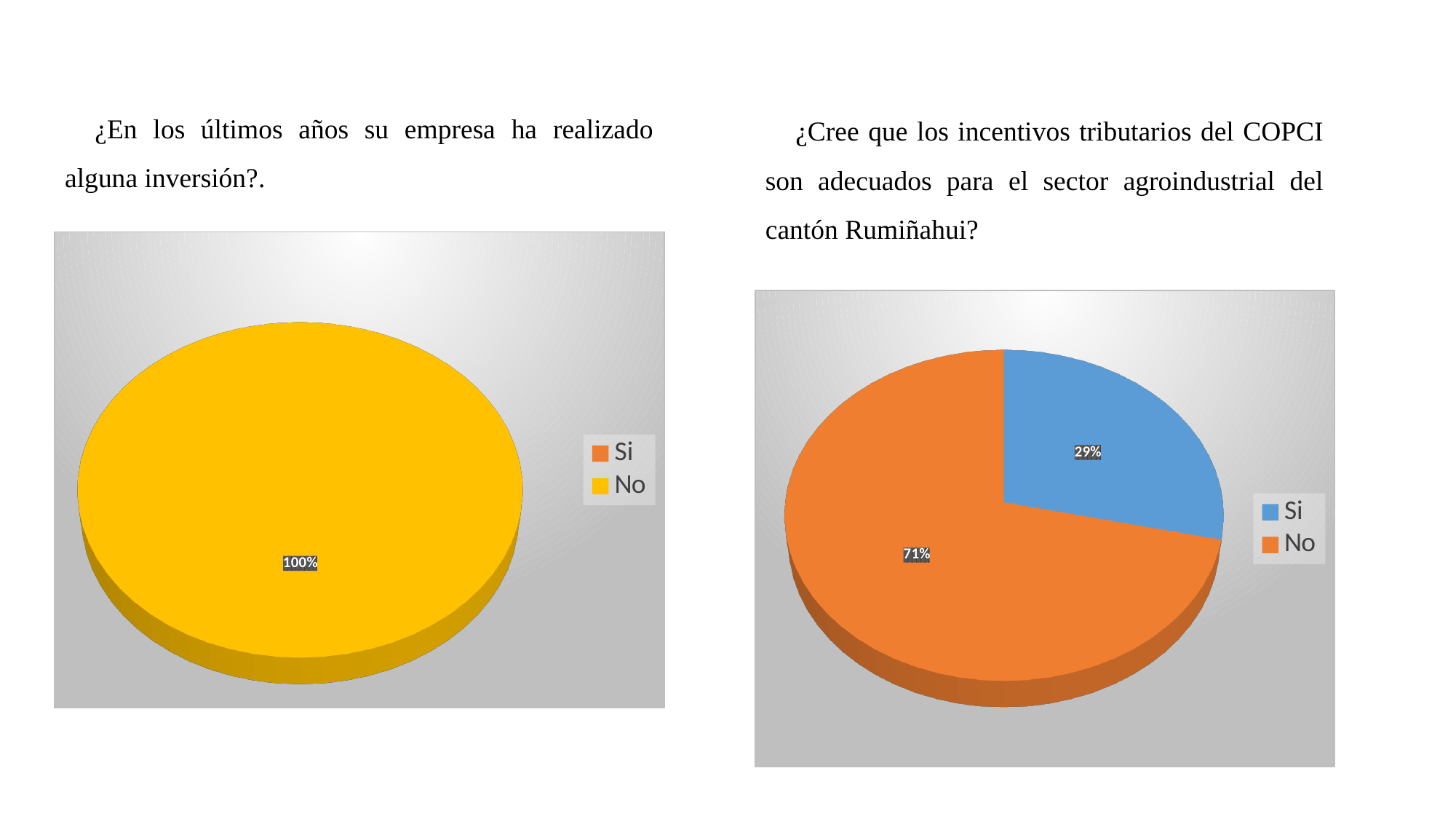
In the right pie chart, what is the difference in percentage points between the 'No' and 'Si' slices? 42 In the right pie chart, which slice is the smallest? Si What kind of chart is the left chart on the slide? pie chart In the right pie chart, what share is labelled for the 'No' slice? 71% In the right pie chart, what share is labelled for the 'Si' slice? 29% How many entries does the legend of the left pie chart list? 2 How many entries does the legend of the right pie chart list? 2 In the right pie chart, is the 'No' slice larger or smaller than the 'Si' slice? larger In the left pie chart, which legend entry is shown in yellow? No In the left pie chart, what share is labelled for the 'No' slice? 100% In the right pie chart, which slice is the largest? No In the right pie chart, which legend entry is shown in blue? Si